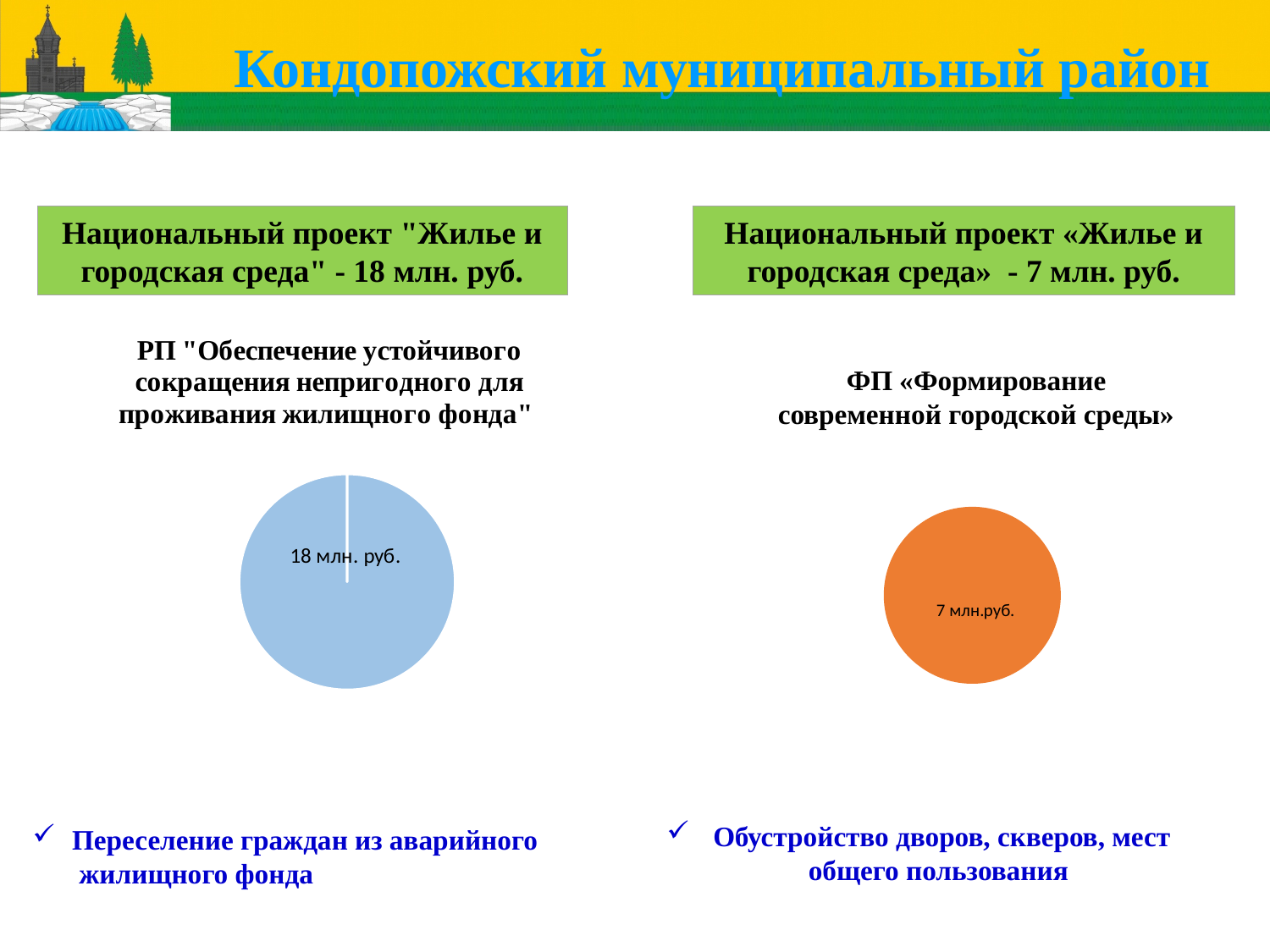
What colour is the slice in the right pie chart? orange Which pie chart shows the larger value, the left one or the right one? the left one What colour is the slice in the left pie chart? light blue What type of chart is shown on the left side of the slide? pie chart What is the difference between the value in the left pie chart and the value in the right pie chart? 11 млн. руб. Is the value shown in the left pie chart greater or less than 10 млн. руб.? greater Is the value shown in the right pie chart greater or less than 10 млн. руб.? less In the right pie chart, what value is printed on the slice? 7 млн.руб. In the left pie chart, what value is printed on the slice? 18 млн. руб. How many slices does the left pie chart have? 1 What type of chart is shown on the right side of the slide? pie chart How many slices does the right pie chart have? 1